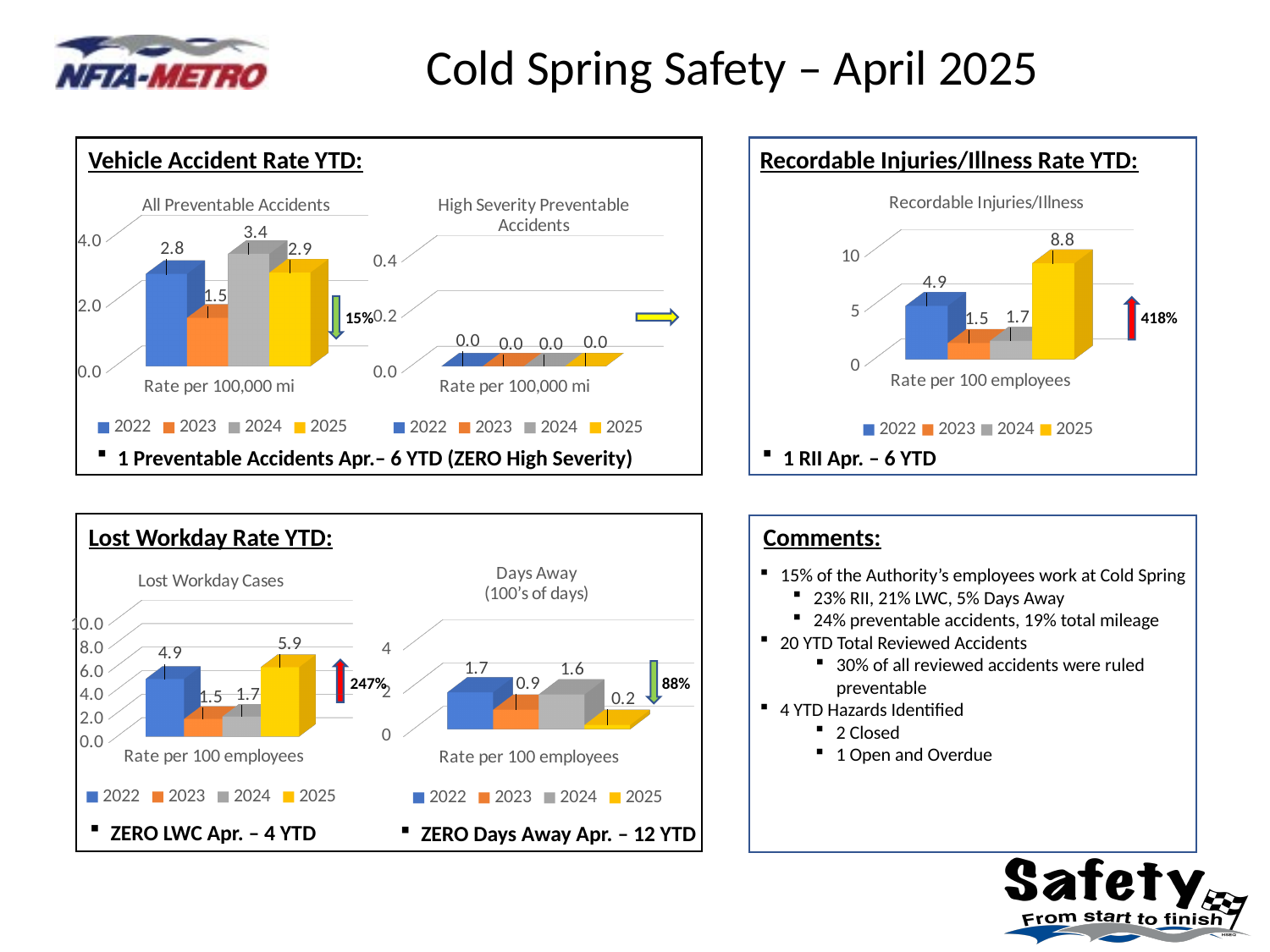
In the Recordable Injuries/Illness chart, which year has the highest value? 2025 In the Days Away chart, which year has the lowest value? 2025 In the All Preventable Accidents chart, which year has the lowest value? 2023 How many series does the legend of the Lost Workday Cases chart list? 4 In the All Preventable Accidents chart, what is the difference between the 2024 and 2025 values? 0.5 In the Recordable Injuries/Illness chart, what is the value for 2022? 4.9 In the Recordable Injuries/Illness chart, what is the difference between the 2025 and 2022 values? 3.9 In the High Severity Preventable Accidents chart, what is the value for 2025? 0.0 In the Lost Workday Cases chart, which is larger, the value for 2022 or the value for 2024? 2022 In the Days Away chart, what is the value for 2023? 0.9 In the All Preventable Accidents chart, what is the value for 2024? 3.4 In the Lost Workday Cases chart, what is the value for 2025? 5.9